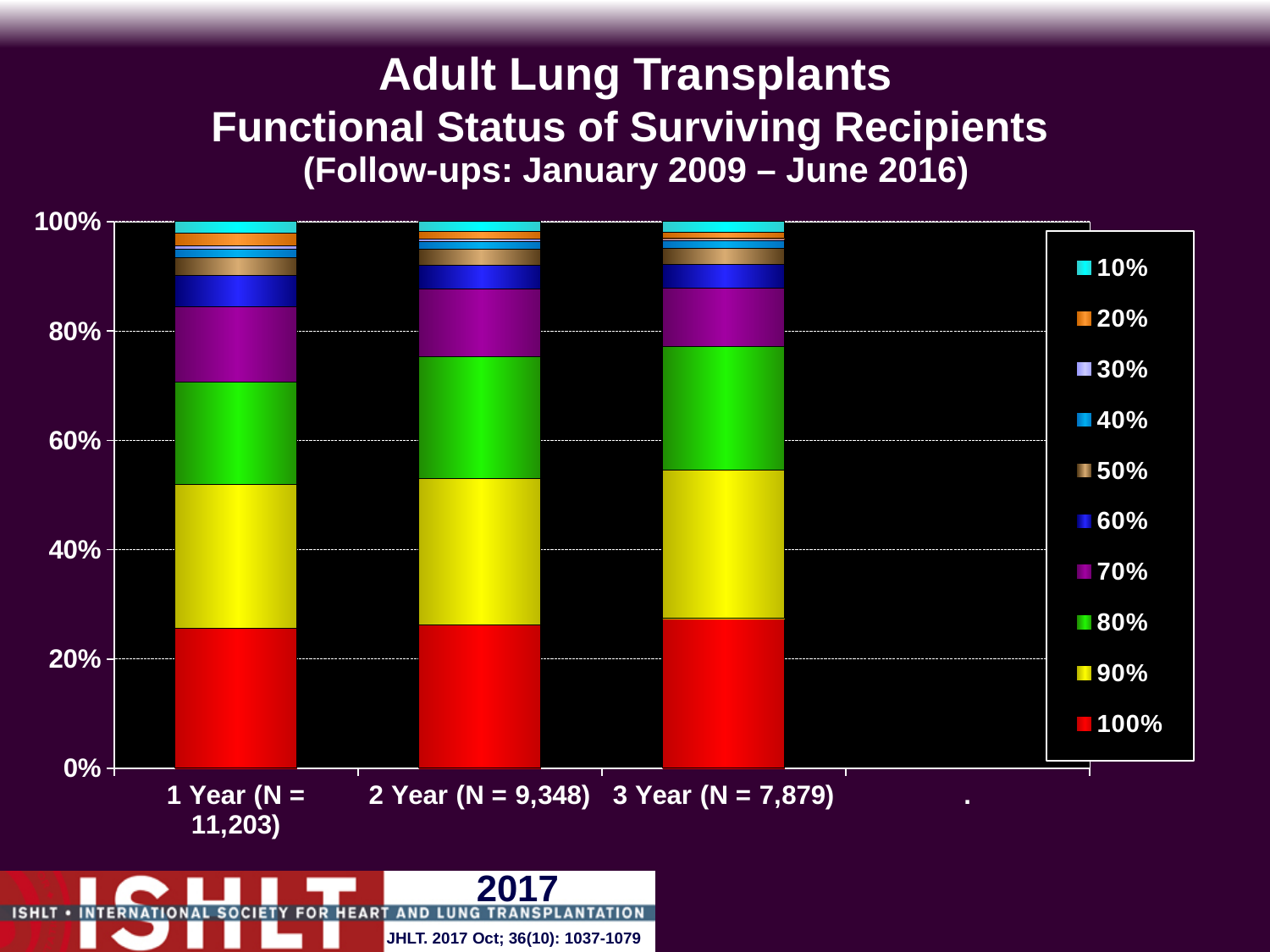
How many follow-up time points (bars) are plotted on the chart? 3 What is the total height of each stacked bar on the chart? 100% At 1 Year, which segment is larger: the 90% functional status segment or the 80% functional status segment? 90% Is the share of 1 Year recipients with 90% functional status greater or less than 20%? greater Is the share of 1 Year recipients with 100% functional status greater or less than 20%? greater What kind of chart is shown on the slide? Stacked bar chart At 1 Year, which segment is larger: the 100% functional status segment or the 70% functional status segment? 100% Which colour represents the 100% functional status category in the legend? Red What is the N shown for the 2 Year follow-up bar? 9,348 Is the share of 1 Year recipients with 70% functional status greater or less than 20%? less How many functional status categories does the legend list? 10